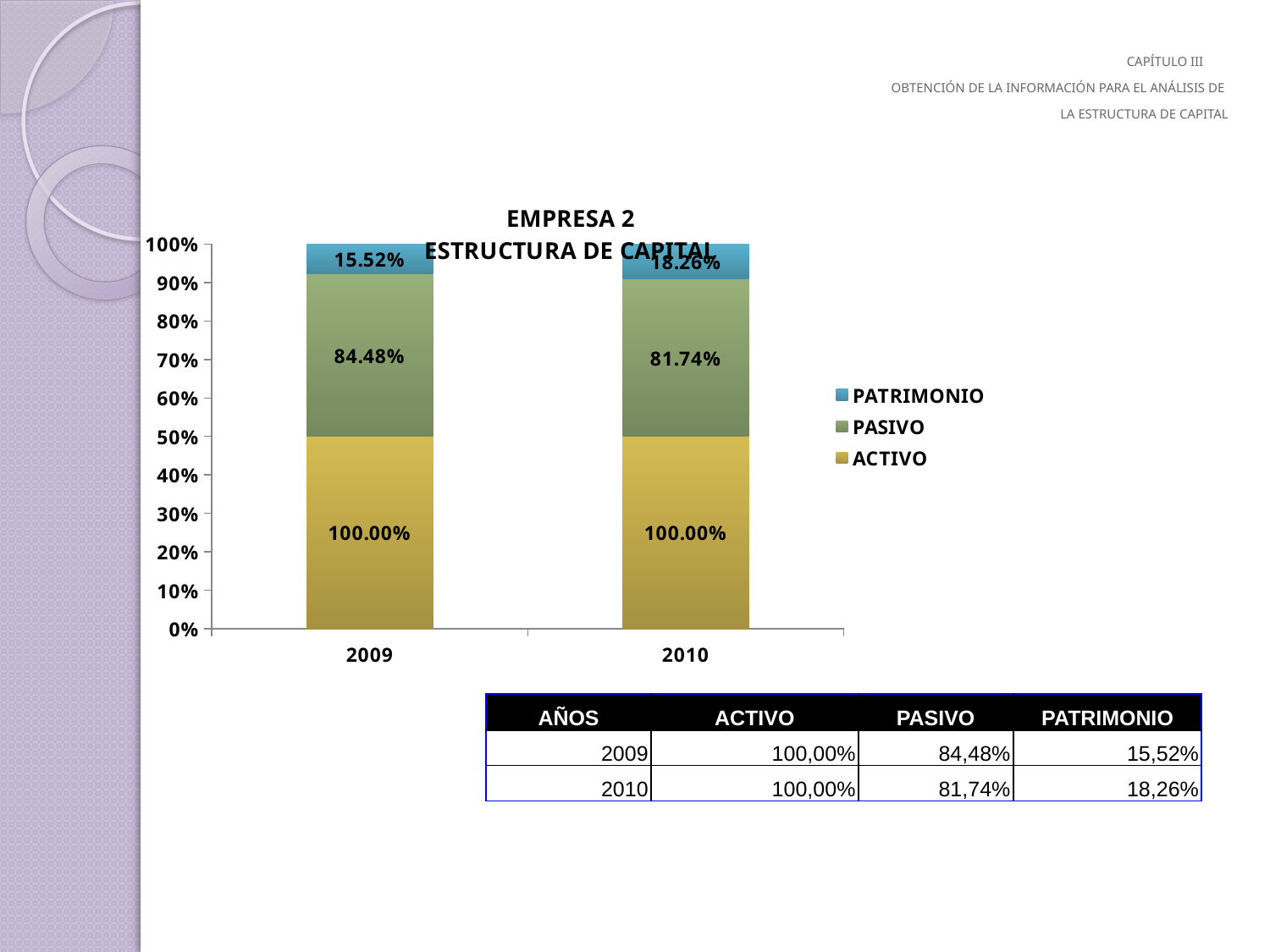
Which year has the higher PATRIMONIO value? 2010 What is the PASIVO value for 2010? 81.74% What type of chart is shown on the slide? Stacked bar chart What is the ACTIVO value for 2010? 100.00% What is the PATRIMONIO value for 2009? 15.52% How many series does the legend list? 3 How many years are shown on the x axis? 2 What is the PASIVO value for 2009? 84.48% By how many percentage points did PASIVO fall from 2009 to 2010? 2.74 Does the PATRIMONIO value rise or fall from 2009 to 2010? Rise Which year has the lower PASIVO value? 2010 What is the PATRIMONIO value for 2010? 18.26%